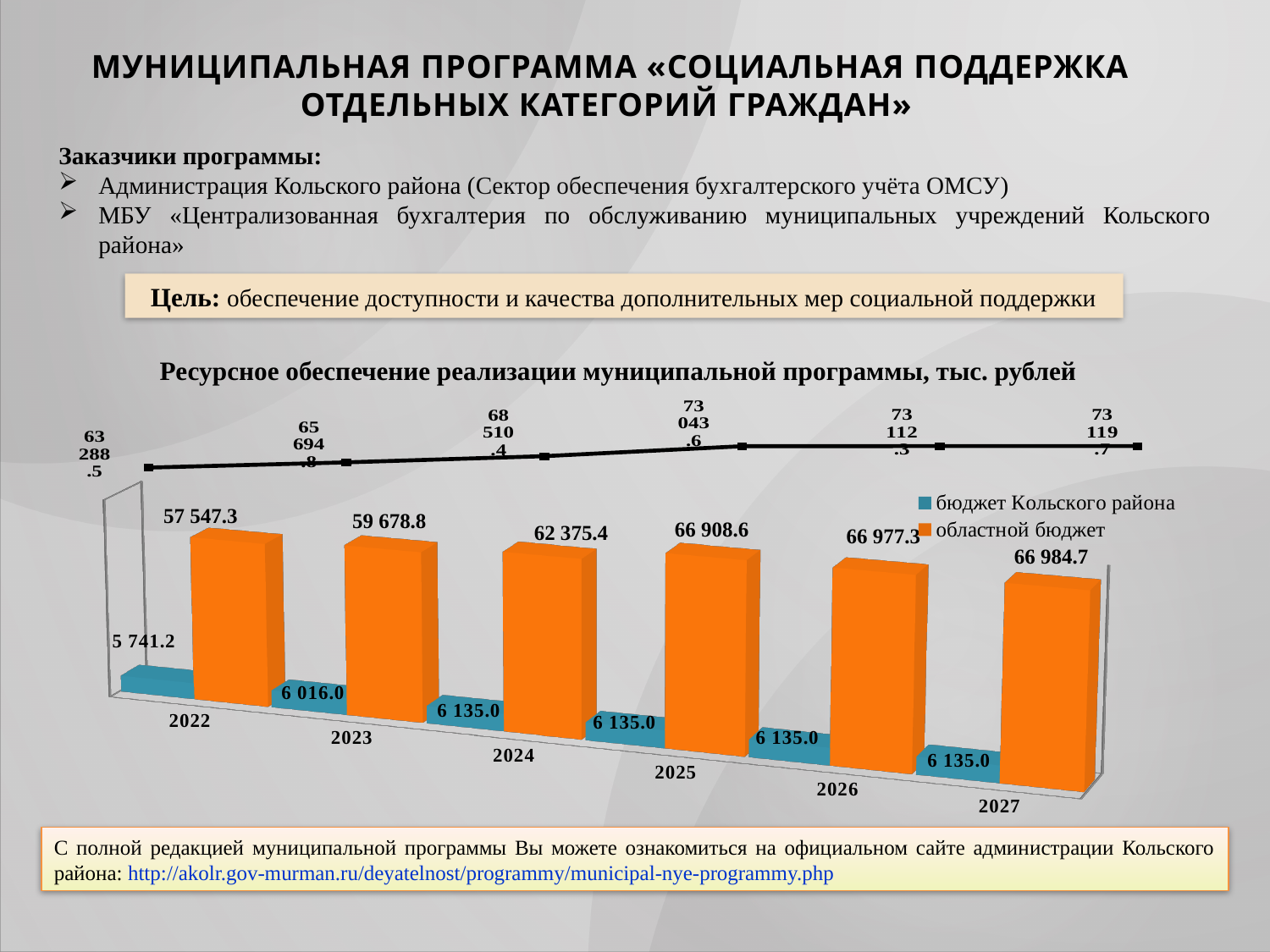
What is the value for областной бюджет in 2027? 66 984.7 What is the title of the chart? Ресурсное обеспечение реализации муниципальной программы, тыс. рублей What is the difference between the областной бюджет values for 2023 and 2022? 2 131.5 Which is larger in 2025: областной бюджет or бюджет Кольского района? областной бюджет What is the value for областной бюджет in 2024? 62 375.4 In which year is the бюджет Кольского района value the lowest? 2022 How many series does the chart legend list? 2 Does the областной бюджет value rise or fall from 2022 to 2027? rise What kind of chart is used to show the budget values? bar chart What is the value for бюджет Кольского района in 2022? 5 741.2 How many years are shown on the x axis of the chart? 6 In which year is the областной бюджет value the lowest? 2022